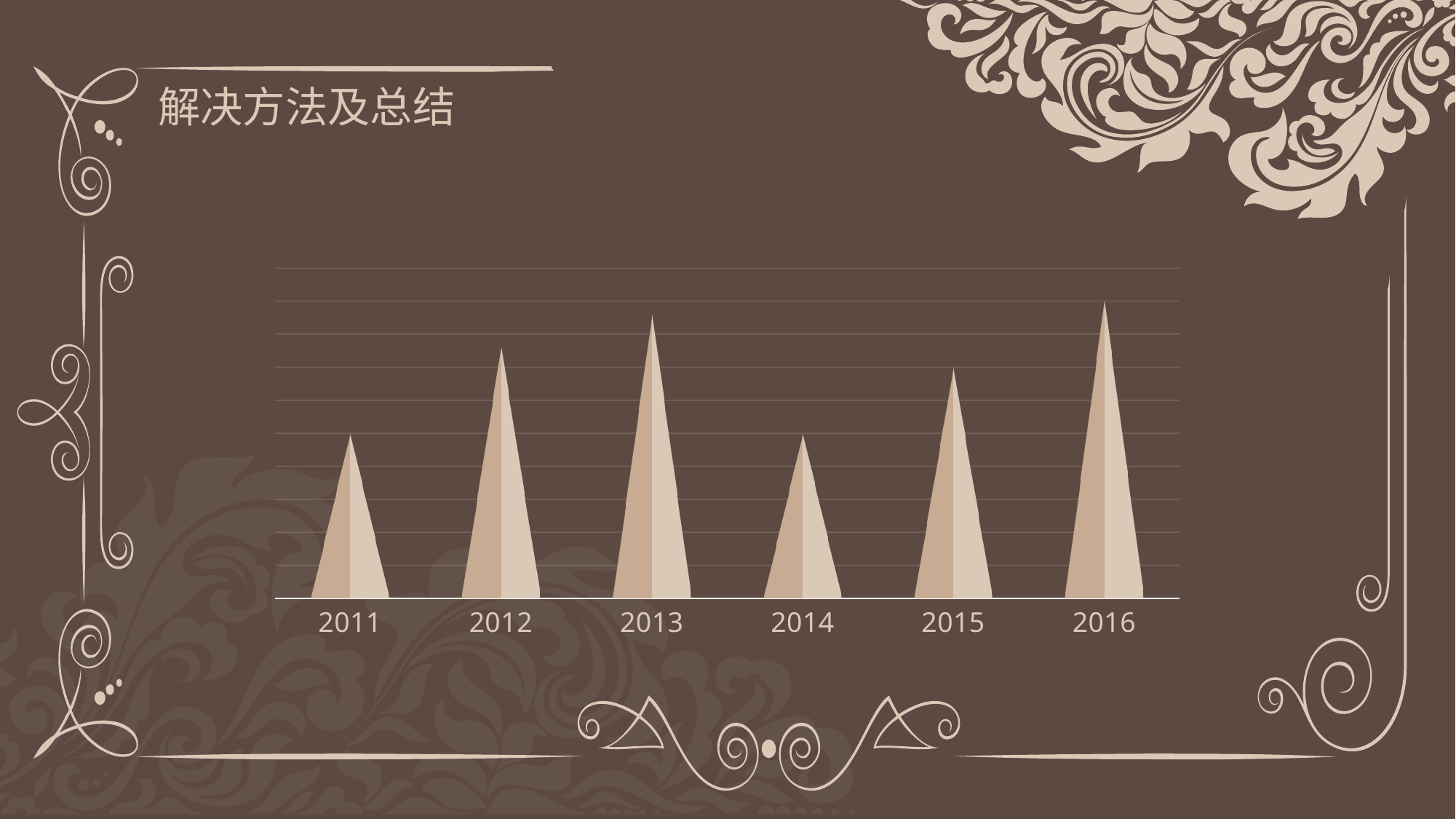
What kind of chart is shown on the slide? bar chart Does the value rise or fall from 2011 to 2013? rise Which is larger, the value for 2015 or the value for 2014? 2015 Which is larger, the value for 2014 or the value for 2016? 2016 Does the value rise or fall from 2013 to 2014? fall What is the first year shown on the x axis of the chart? 2011 What is the last year shown on the x axis of the chart? 2016 How many categories (years) are shown on the x axis of the chart? 6 Which is larger, the value for 2011 or the value for 2013? 2013 Does the value rise or fall from 2014 to 2016? rise